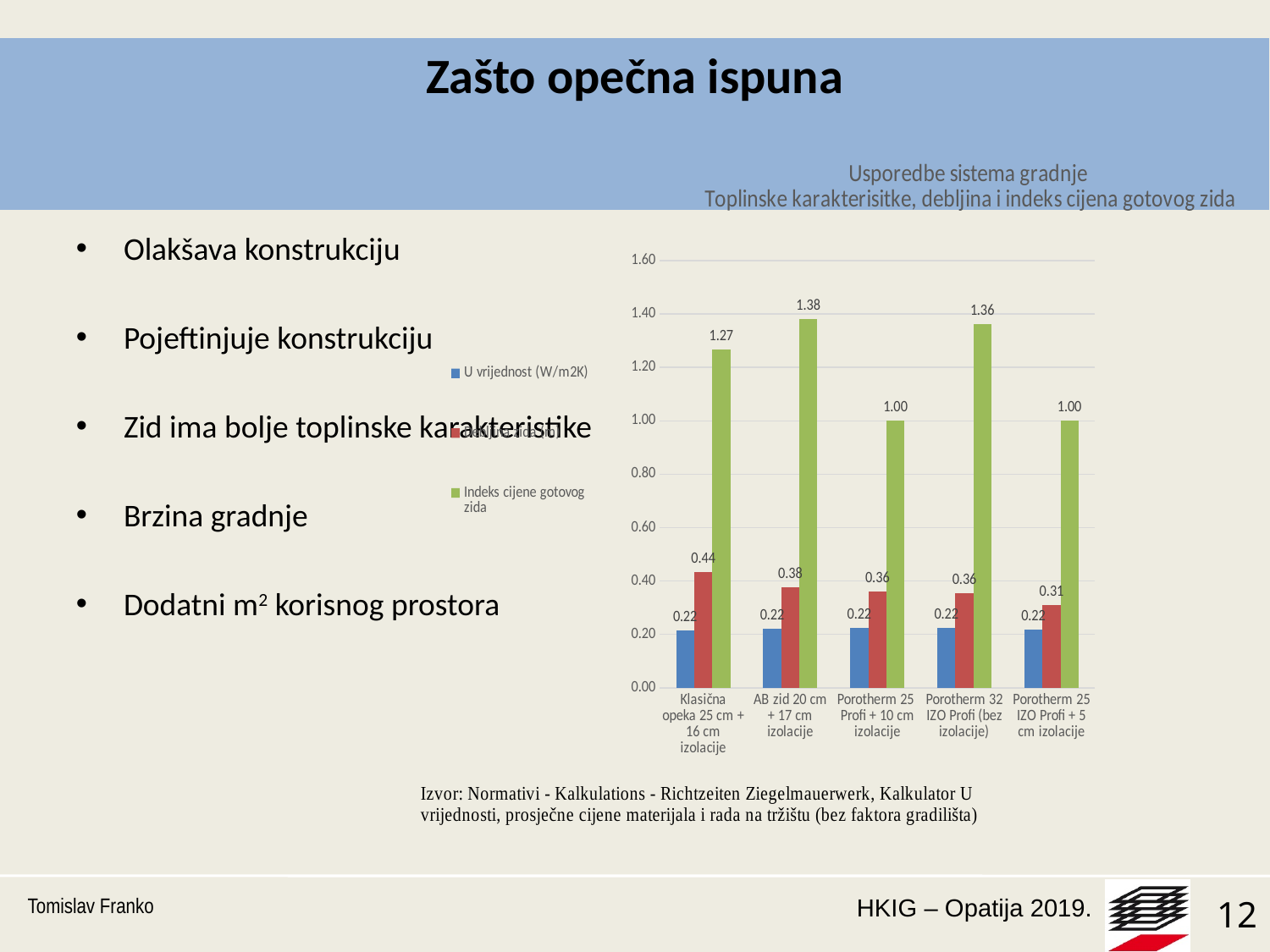
What value is labelled on the red bar for Klasična opeka 25 cm + 16 cm izolacije? 0.44 What is the Indeks cijene gotovog zida value for Klasična opeka 25 cm + 16 cm izolacije? 1.27 How many wall system categories are shown on the x axis? 5 How many series does the legend list? 3 What kind of chart is shown on the slide? bar chart What is the Indeks cijene gotovog zida value for AB zid 20 cm + 17 cm izolacije? 1.38 What is the difference in Indeks cijene gotovog zida between AB zid 20 cm + 17 cm izolacije and Klasična opeka 25 cm + 16 cm izolacije? 0.11 Which has a higher Indeks cijene gotovog zida: Klasična opeka 25 cm + 16 cm izolacije or Porotherm 32 IZO Profi (bez izolacije)? Porotherm 32 IZO Profi (bez izolacije) Which category has the highest Indeks cijene gotovog zida? AB zid 20 cm + 17 cm izolacije What is the difference in Indeks cijene gotovog zida between AB zid 20 cm + 17 cm izolacije and Porotherm 25 Profi + 10 cm izolacije? 0.38 Is the Indeks cijene gotovog zida for Porotherm 25 IZO Profi + 5 cm izolacije greater or less than 1.20? less What is the U vrijednost (W/m2K) for Porotherm 32 IZO Profi (bez izolacije)? 0.22